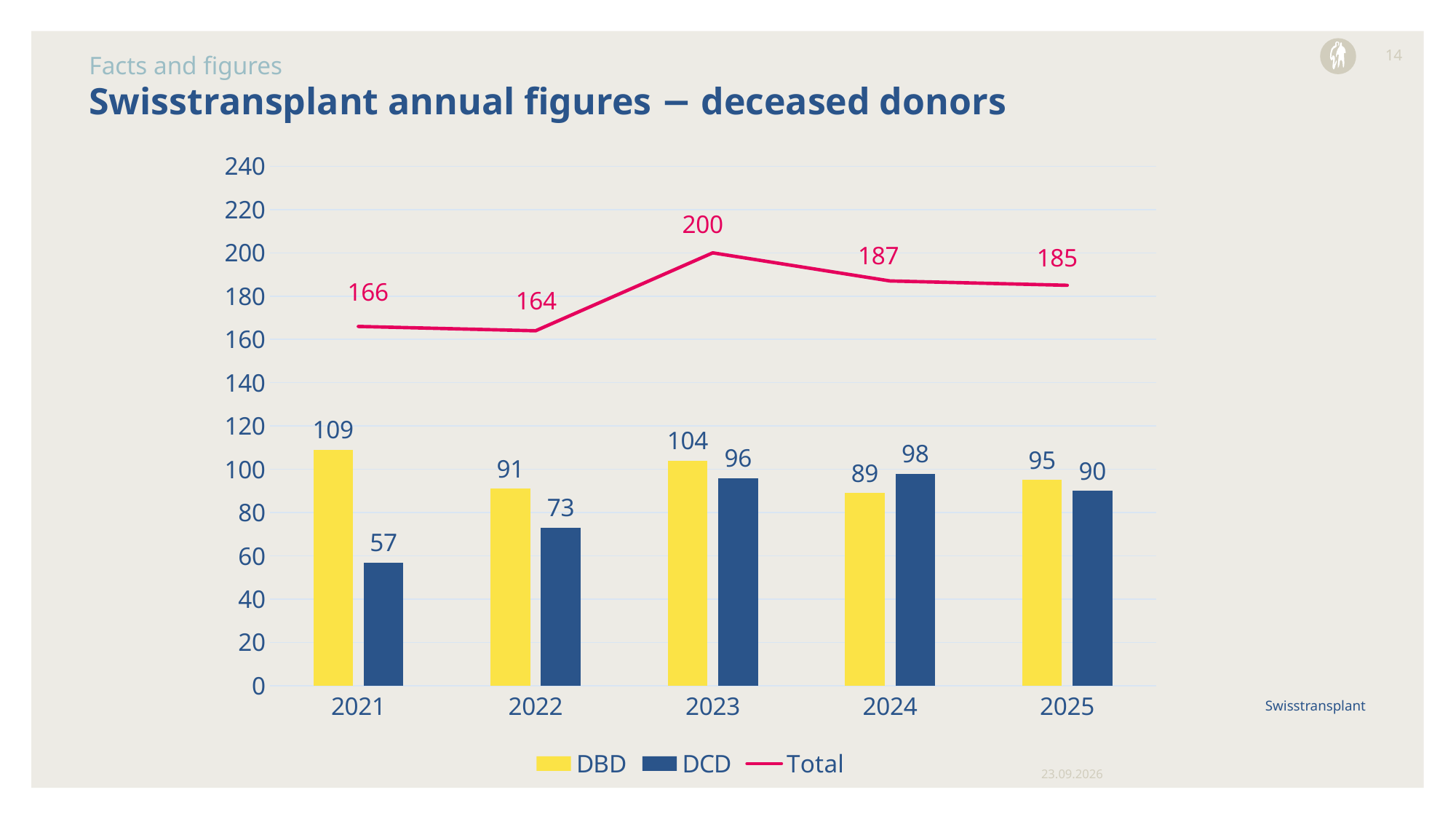
What is the difference between the DBD and DCD values in 2021? 52 What is the DCD value for 2024? 98 What colour are the DBD bars? Yellow How many series does the legend list? 3 Does the DBD value rise or fall from 2021 to 2022? Fall Which is larger in 2024, DBD or DCD? DCD What kind of chart is this? Combined bar and line chart Which year has the highest Total? 2023 What is the Total value for 2023? 200 How many years are shown on the x axis? 5 Which year has the lowest DCD value? 2021 What is the DBD value for 2021? 109